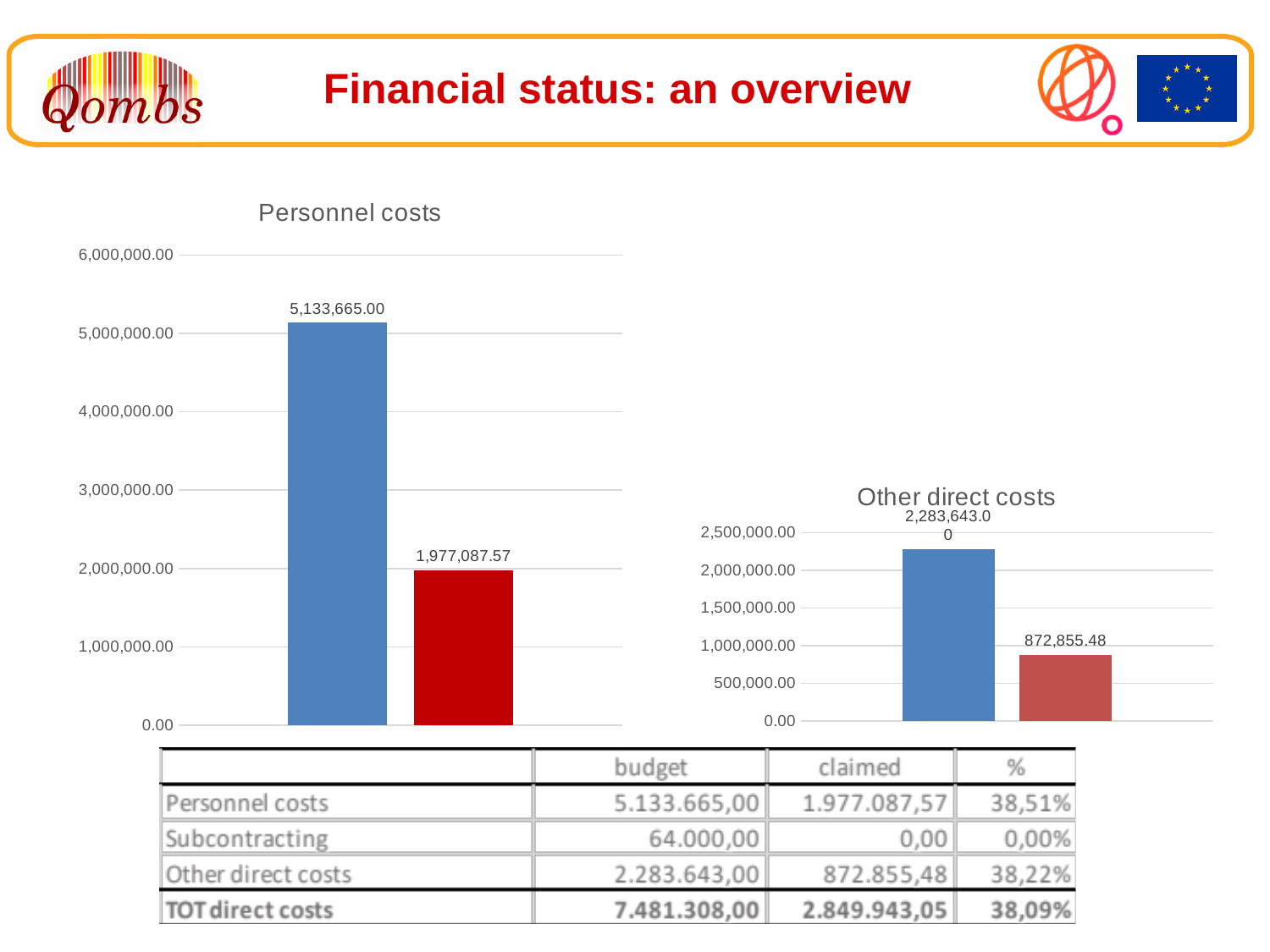
In the Personnel costs chart, which bar is taller, the blue one or the red one? the blue one In the Other direct costs chart, what is the value shown on the blue (left) bar? 2,283,643.00 In the Other direct costs chart, what is the difference between the blue bar and the red bar? 1,410,787.52 In the Personnel costs chart, what is the value shown on the red (right) bar? 1,977,087.57 In the Personnel costs chart, what is the value shown on the blue (left) bar? 5,133,665.00 In the Personnel costs chart, what is the difference between the blue bar and the red bar? 3,156,577.43 What type of chart is the Other direct costs chart? bar chart In the Other direct costs chart, which bar has the lowest value? the red (right) bar How many bars are plotted in the Personnel costs chart? 2 In the Personnel costs chart, is the value of the red bar greater or less than 2,000,000.00? less In the Other direct costs chart, is the value of the blue bar greater or less than 2,000,000.00? greater In the Other direct costs chart, what is the value shown on the red (right) bar? 872,855.48